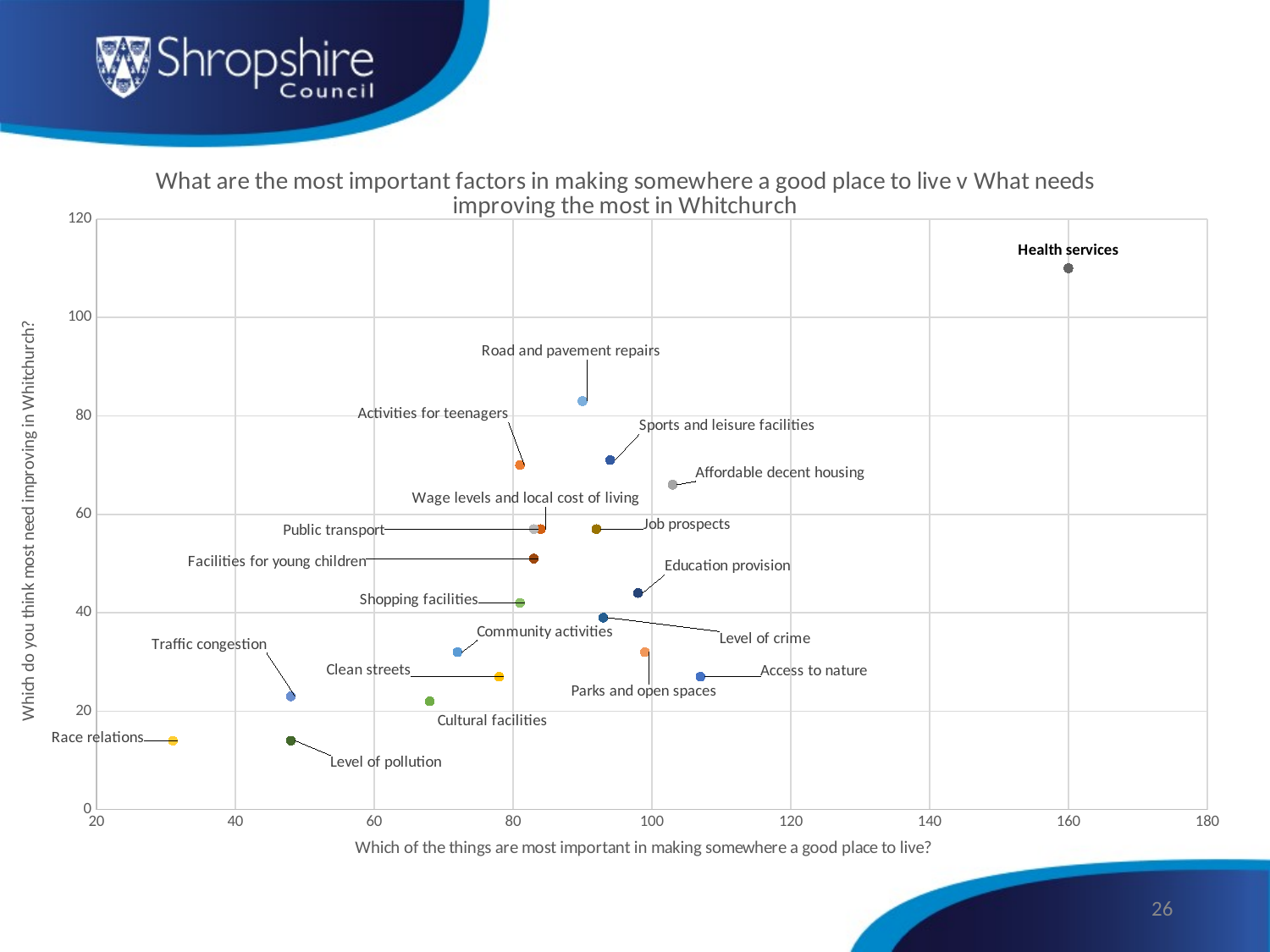
Is the horizontal-axis value for Access to nature greater or less than 100? greater What is the title of the vertical axis? Which do you think most need improving in Whitchurch? Is the vertical-axis value for Cultural facilities greater or less than 40? less How many labelled points are plotted on the chart? 20 Which factor has the highest value on the vertical axis (needs improving the most)? Health services Which factor is plotted furthest to the right on the horizontal axis (most important in making somewhere a good place to live)? Health services Which has the higher vertical-axis value, Road and pavement repairs or Sports and leisure facilities? Road and pavement repairs What is the title of the horizontal axis? Which of the things are most important in making somewhere a good place to live? Is the horizontal-axis value for Traffic congestion greater or less than 60? less Which factor is plotted furthest to the left on the horizontal axis? Race relations What kind of chart is shown on the slide? scatter chart